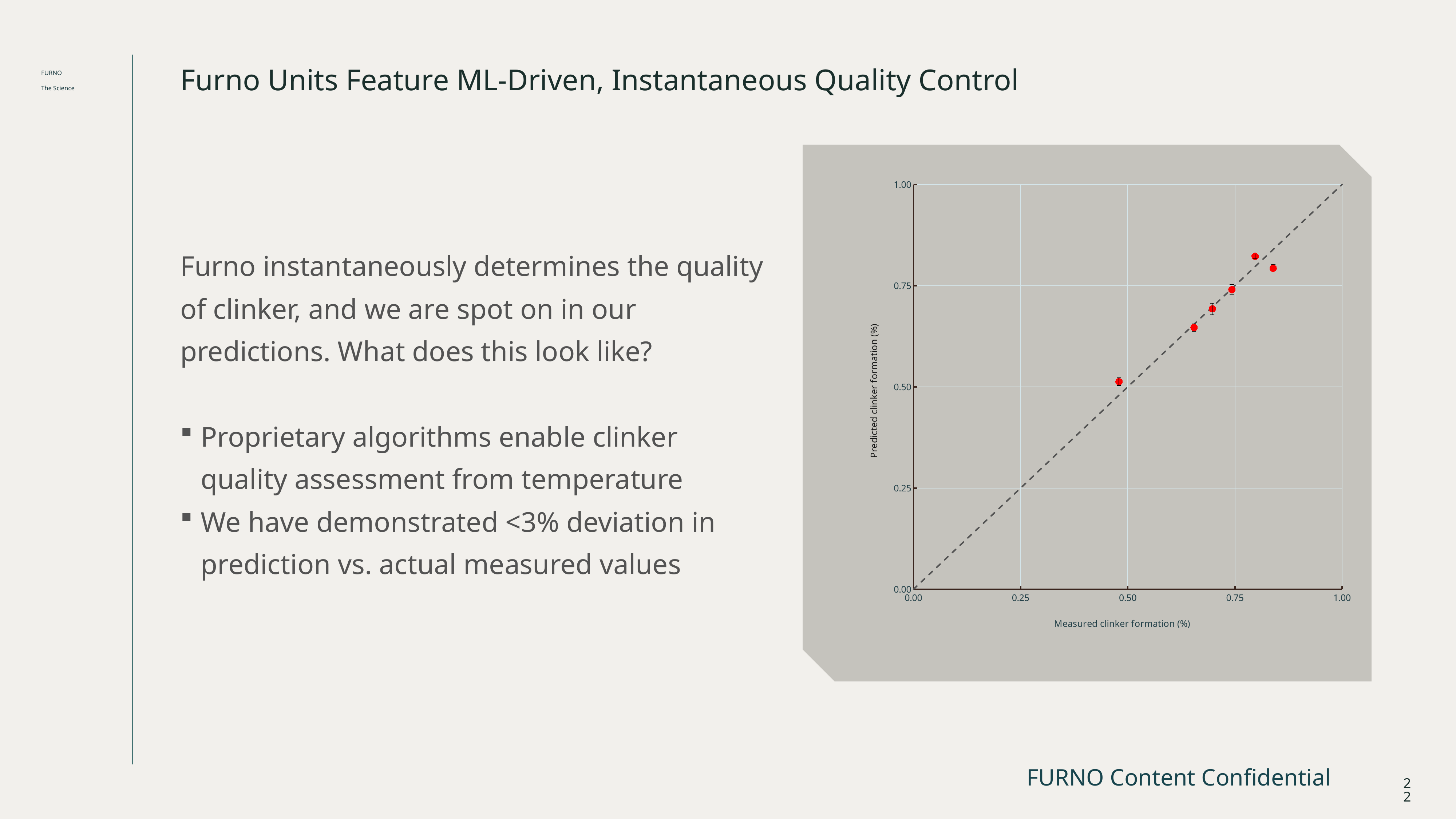
What is the label of the x axis of the chart? Measured clinker formation (%) How many data points are plotted on the chart? 6 Is the predicted clinker formation for the point with the highest measured value greater or less than 0.75? greater What is the label of the y axis of the chart? Predicted clinker formation (%) What kind of chart is shown on the slide? Scatter plot Is the predicted clinker formation for the point with the lowest measured value greater or less than 0.75? less Are any of the plotted points below 0.25 on the predicted clinker formation axis? No Do the predicted values generally rise or fall as the measured clinker formation increases? Rise What is the maximum value shown on the x axis of the chart? 1.00